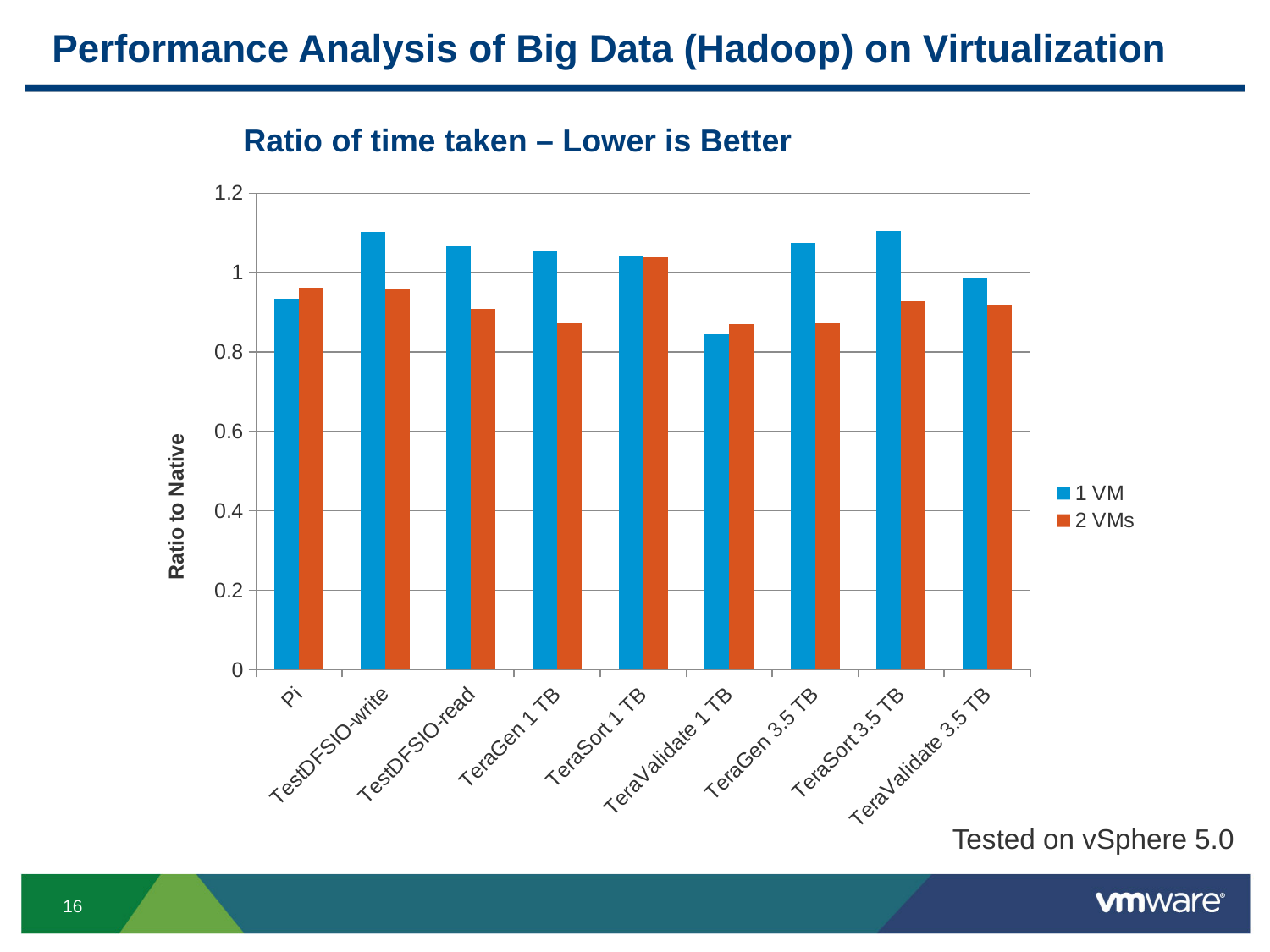
What kind of chart is shown on the slide? bar chart Which category has the lowest value for the 1 VM series? TeraValidate 1 TB Is the 2 VMs value for TeraSort 3.5 TB greater or less than 1? less What is the label of the y axis? Ratio to Native How many benchmark categories are shown on the x axis? 9 Is the 1 VM value for TeraValidate 1 TB greater or less than 1? less Is the 1 VM value for TeraGen 3.5 TB greater or less than 1? greater For TeraGen 1 TB, which is larger: the 1 VM value or the 2 VMs value? 1 VM For TestDFSIO-write, which is larger: the 1 VM value or the 2 VMs value? 1 VM Which category has the highest value for the 2 VMs series? TeraSort 1 TB How many series does the legend list? 2